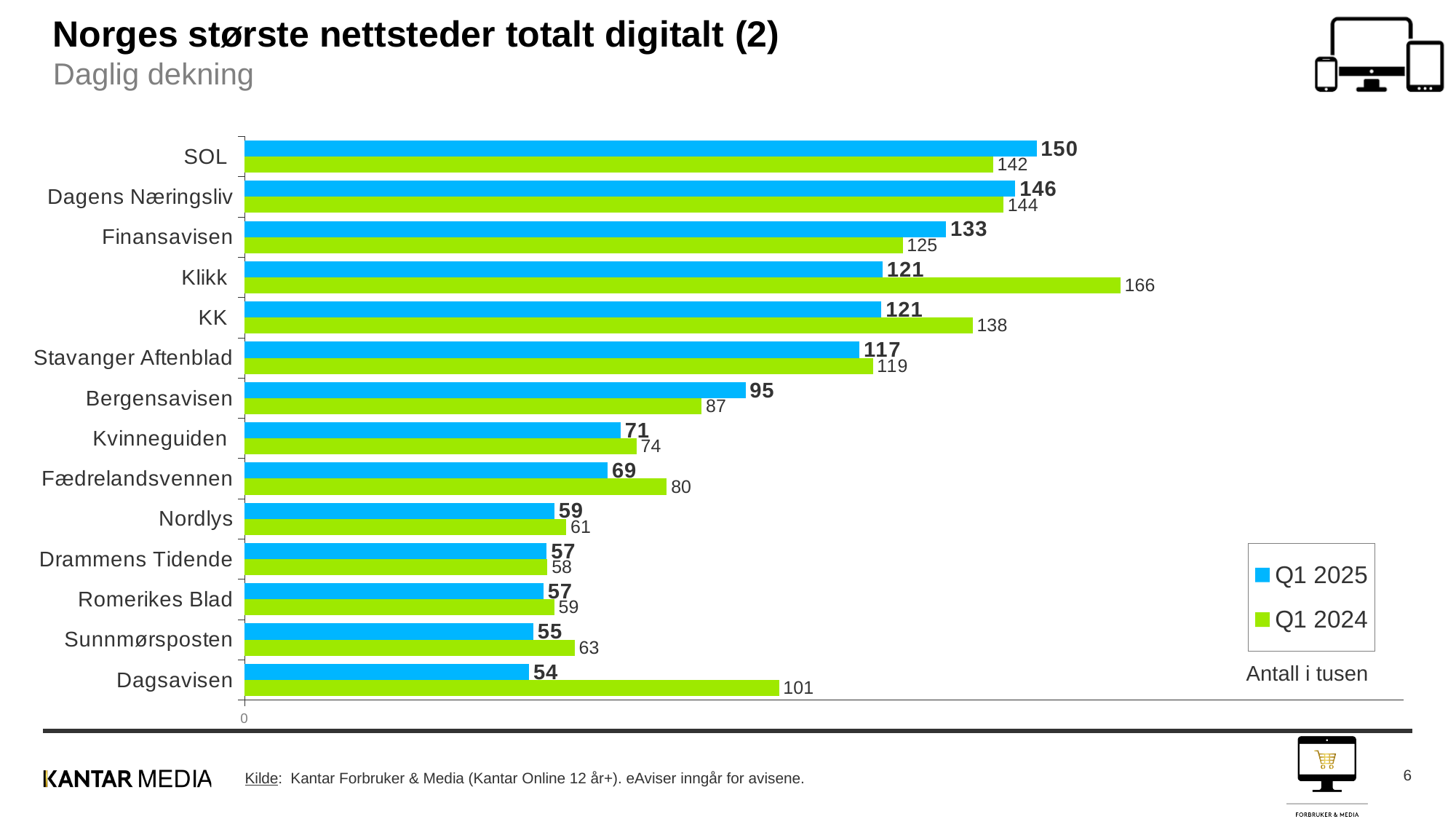
Which category has the lowest Q1 2025 value? Dagsavisen What is the difference between the Q1 2024 and Q1 2025 values for Dagsavisen? 47 What kind of chart is shown on the slide? Bar chart What is the Q1 2024 value for Dagsavisen? 101 How many series does the legend list? 2 What unit note is shown below the legend? Antall i tusen Which category has the highest Q1 2024 value? Klikk Which category has the highest Q1 2025 value? SOL How many categories are shown on the chart? 14 What is the Q1 2024 value for Klikk? 166 What is the Q1 2025 value for SOL? 150 Which is larger for Finansavisen: the Q1 2025 value or the Q1 2024 value? Q1 2025